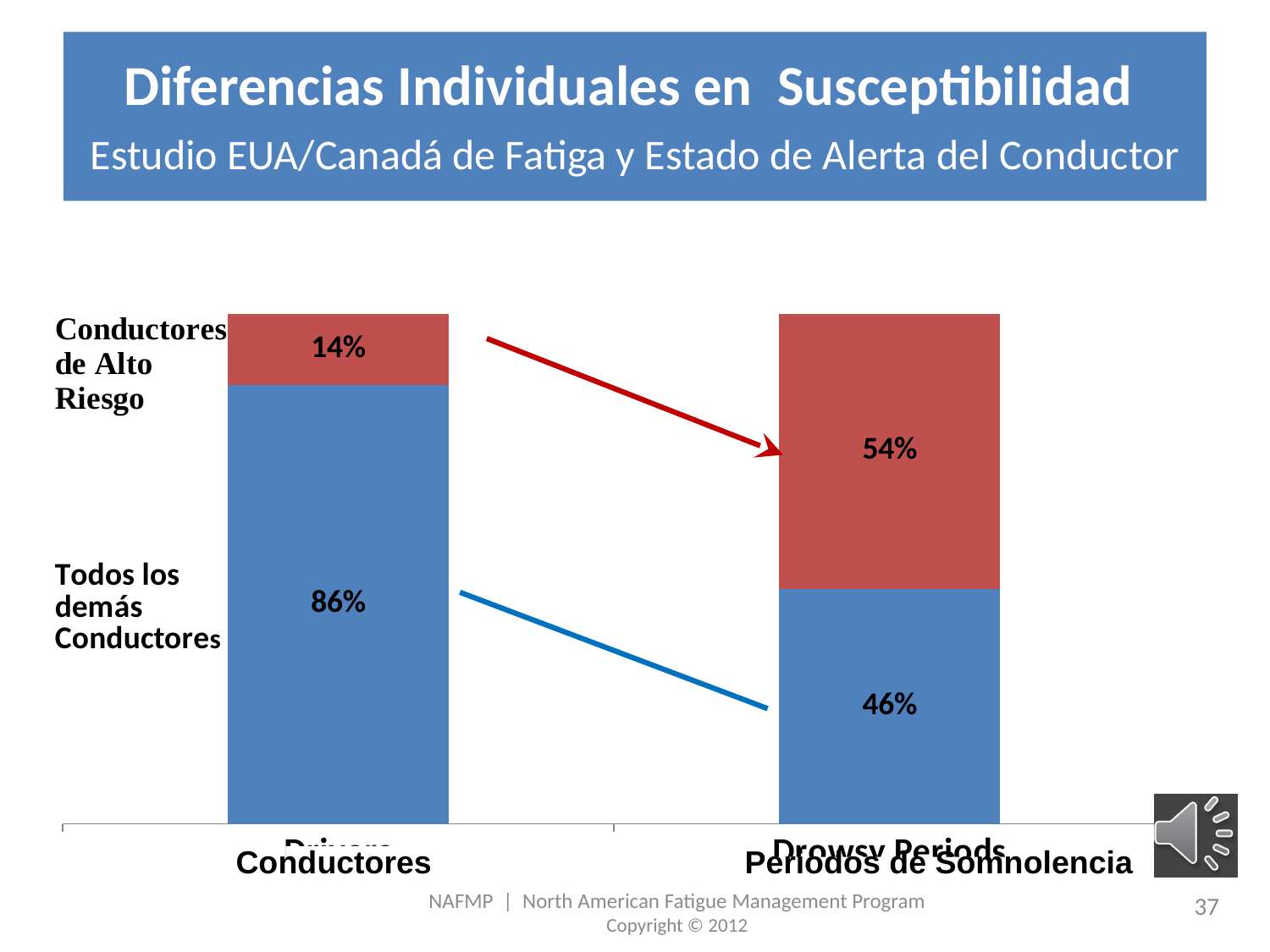
What is the total of the Periodos de Somnolencia stacked bar? 100% What is the difference between the Conductores de Alto Riesgo share in Periodos de Somnolencia and in Conductores? 40% What is the value for Conductores de Alto Riesgo in the Conductores bar? 14% What is the value for Conductores de Alto Riesgo in the Periodos de Somnolencia bar? 54% Which is larger in the Conductores bar: Conductores de Alto Riesgo or Todos los demás Conductores? Todos los demás Conductores Which is larger in the Periodos de Somnolencia bar: Conductores de Alto Riesgo or Todos los demás Conductores? Conductores de Alto Riesgo What kind of chart is shown on the slide? Stacked bar chart What is the value for Todos los demás Conductores in the Periodos de Somnolencia bar? 46% What is the difference between the Todos los demás Conductores share in Conductores and in Periodos de Somnolencia? 40% What is the value for Todos los demás Conductores in the Conductores bar? 86% Which colour represents Conductores de Alto Riesgo in the chart? Red How many bars (categories) are plotted on the chart? 2